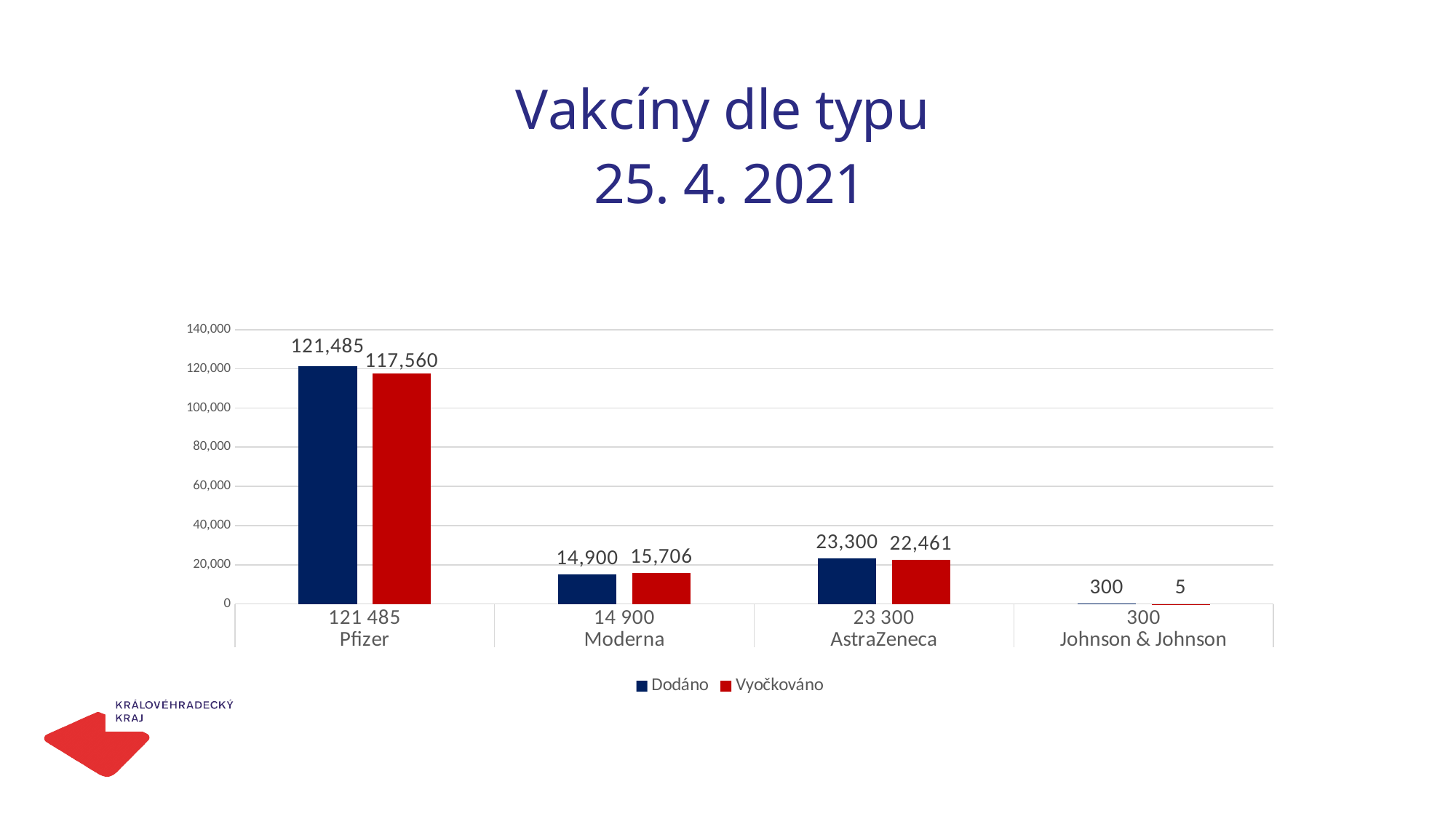
Is the Vyočkováno value for AstraZeneca greater or less than 20,000? greater How many series does the legend list? 2 What is the Dodáno value for AstraZeneca? 23,300 Which vaccine type has the lowest Vyočkováno value? Johnson & Johnson What is the Vyočkováno value for Johnson & Johnson? 5 Which vaccine type has the highest Dodáno value? Pfizer What kind of chart is shown on the slide? bar chart What is the difference between the Dodáno and Vyočkováno values for Pfizer? 3,925 How many vaccine types are shown on the x axis? 4 What is the Vyočkováno value for Moderna? 15,706 Which is larger for Moderna, the Dodáno value or the Vyočkováno value? Vyočkováno What is the Dodáno value for Pfizer? 121,485